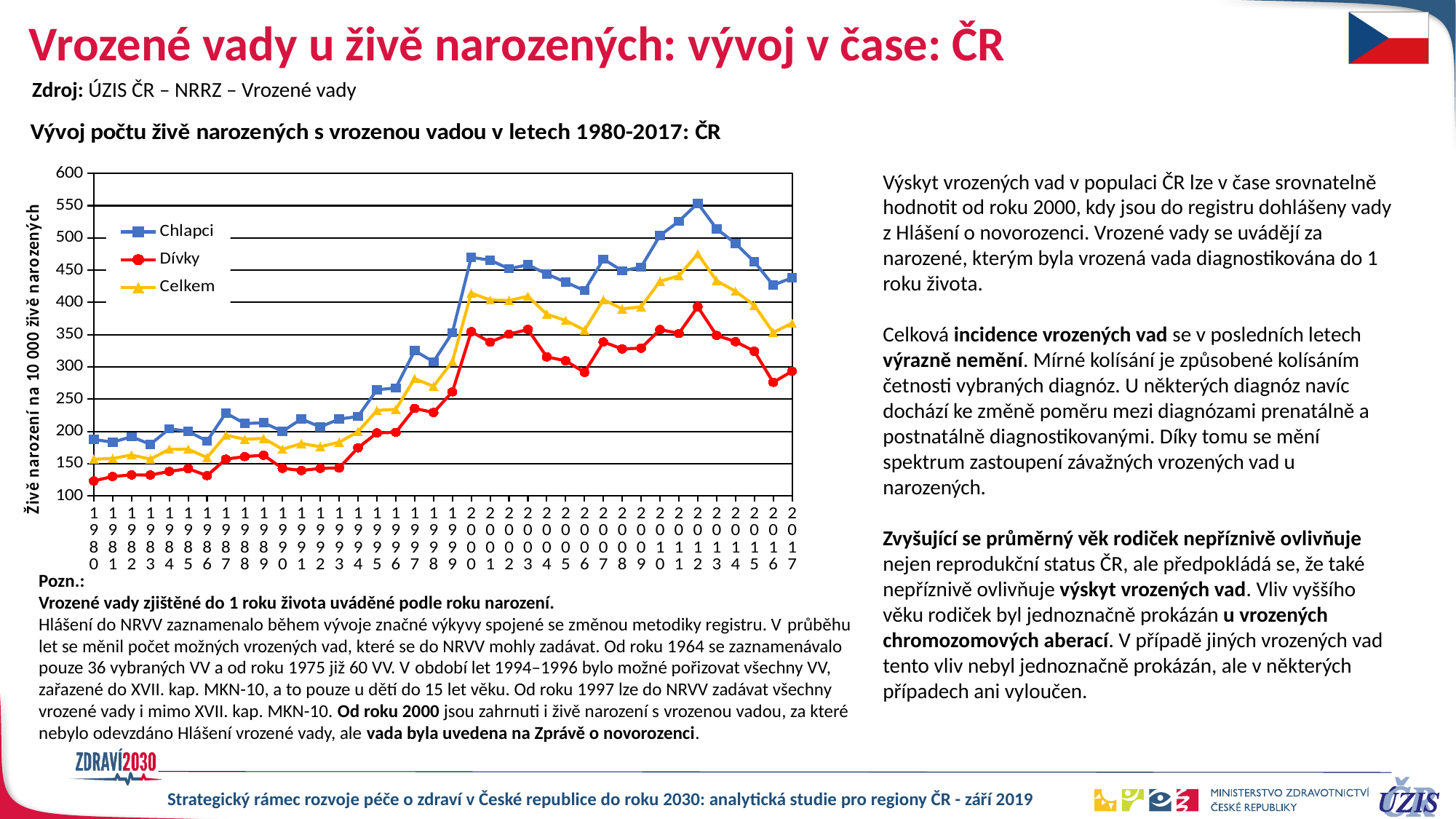
Is the value for Dívky in 1980 greater or less than 150? less What is the label of the vertical axis of the chart? Živě narození na 10 000 živě narozených What kind of chart is shown on the slide? line chart In which year does the Celkem series reach its highest value? 2012 In which year does the Chlapci series reach its highest value? 2012 Do the values of the Celkem series generally rise or fall between 1980 and 2000? rise Which series has the larger value in 2010, Chlapci or Dívky? Chlapci Which series are listed in the chart legend? Chlapci, Dívky, Celkem Is the value for Chlapci in 1980 greater or less than 200? less How many series does the chart legend list? 3 Is the value for Chlapci in 2012 greater or less than 500? greater How many years are plotted along the x axis of the chart? 38